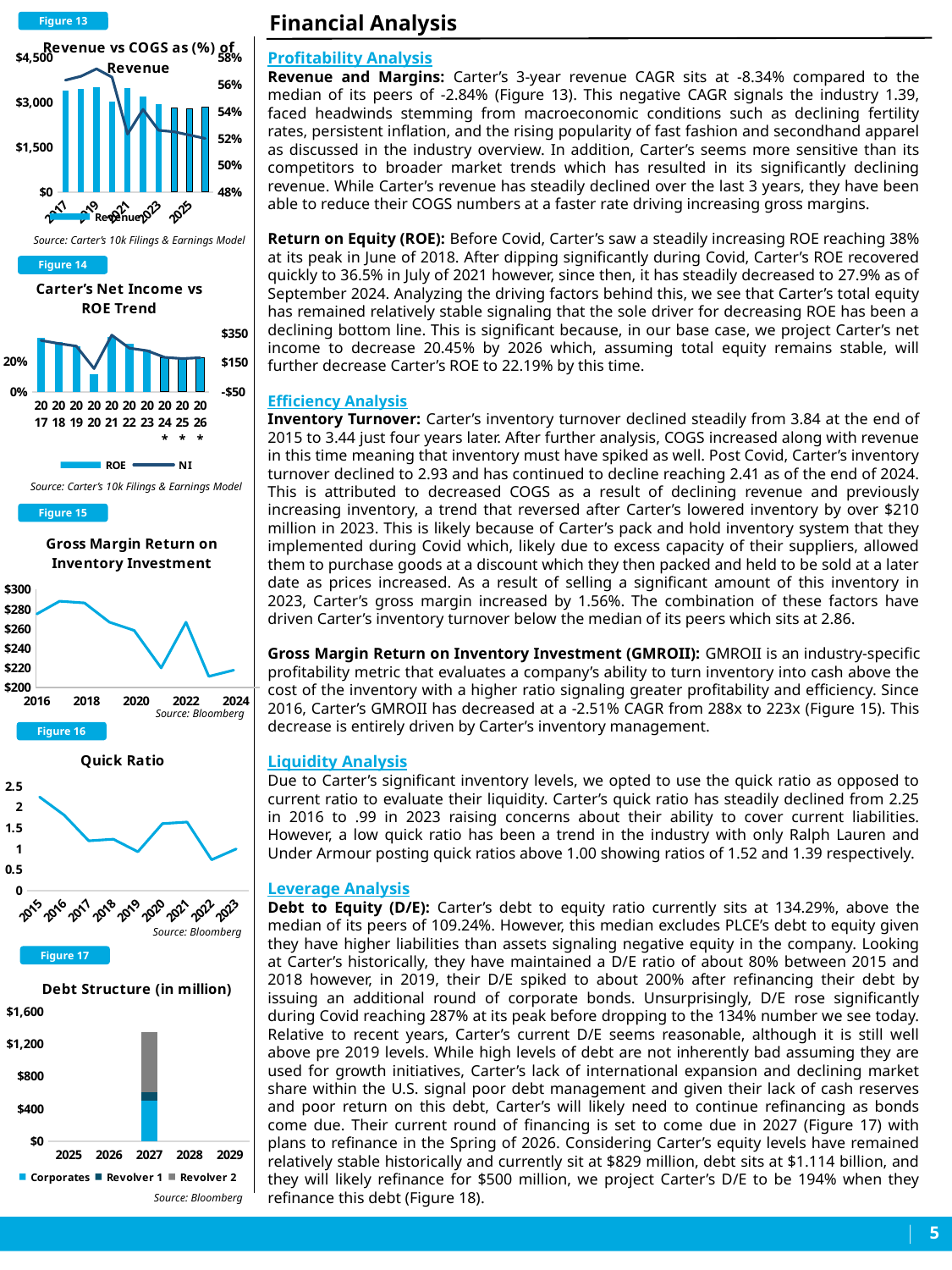
In the Debt Structure (in million) chart (Figure 17), which year has the only bar shown? 2027 In the Quick Ratio chart (Figure 16), which year has the highest quick ratio? 2015 In the Revenue vs COGS as (%) of Revenue chart (Figure 13), do the revenue bars generally rise or fall from 2017 to 2025? Fall In the Quick Ratio chart (Figure 16), is the value for 2015 greater or less than 2? greater In the Quick Ratio chart (Figure 16), what kind of chart is used? Line chart In the Gross Margin Return on Inventory Investment chart (Figure 15), do the values generally rise or fall from 2016 to 2024? Fall In the Gross Margin Return on Inventory Investment chart (Figure 15), is the value for 2022 greater or less than $240? greater In the Carter's Net Income vs ROE Trend chart (Figure 14), what are the two series named in the legend? ROE and NI In the Quick Ratio chart (Figure 16), how many years are plotted on the x axis? 9 In the Debt Structure (in million) chart (Figure 17), how many series does the legend list? 3 In the Gross Margin Return on Inventory Investment chart (Figure 15), is the value for 2021 greater or less than $240? less